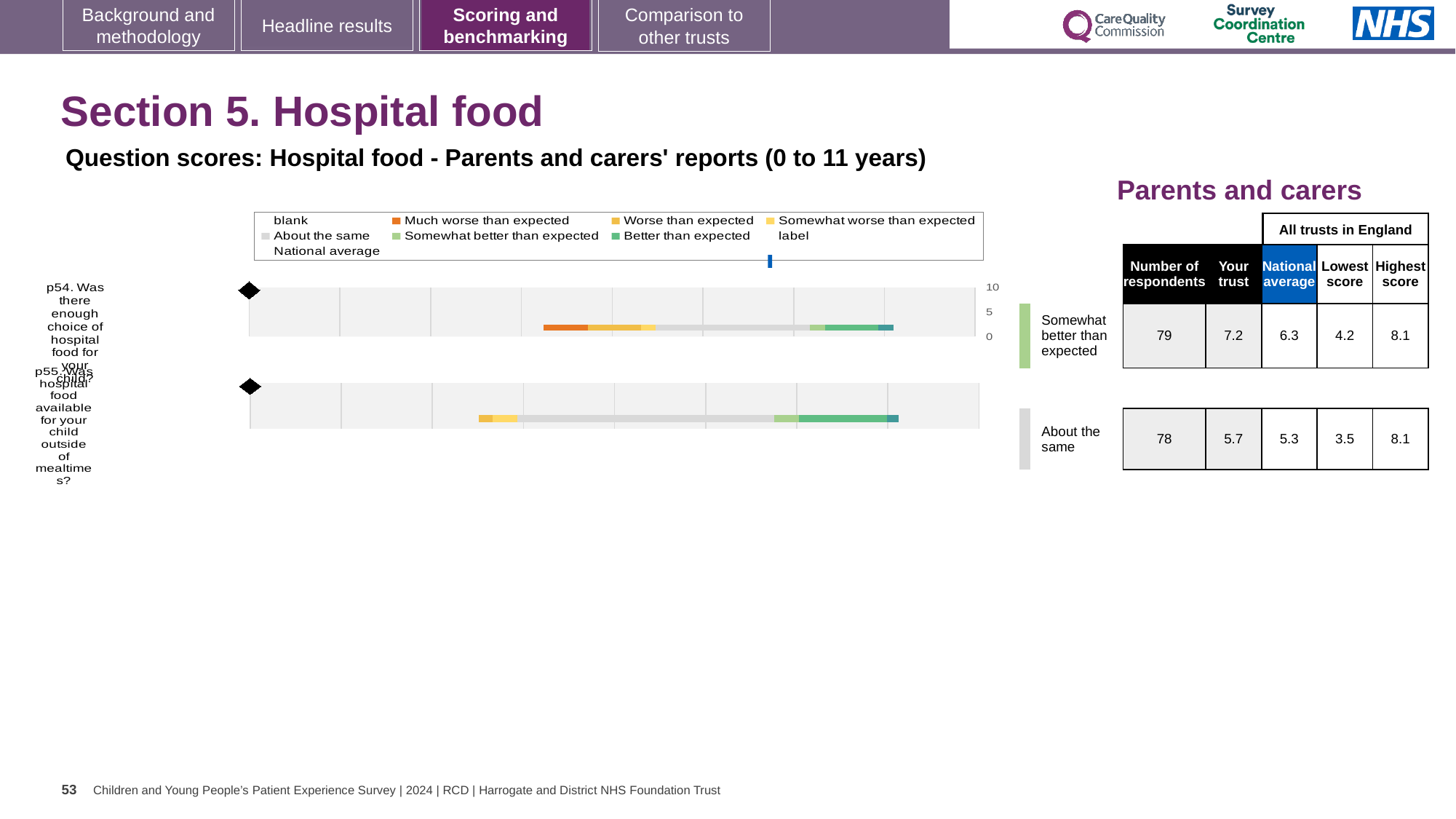
How many respondents answered p55 (hospital food available outside of mealtimes)? 78 What is the difference between the highest and lowest scores for p55 across all trusts in England? 4.6 Which question has the higher 'Your trust' score, p54 or p55? p54 What is the national average score for p54 (enough choice of hospital food)? 6.3 What is the lowest score among all trusts in England for p54? 4.2 How many questions are plotted in the hospital food chart? 2 What colour represents 'Much worse than expected' in the chart legend? orange What is the highest score among all trusts in England for p55? 8.1 What is the 'Your trust' score for p54 (enough choice of hospital food for your child)? 7.2 By how much does the trust's score for p54 exceed the national average for p54? 0.9 What kind of chart is used to show the question scores for hospital food? bar chart Which benchmark category is p55 (hospital food available outside of mealtimes) placed in? About the same